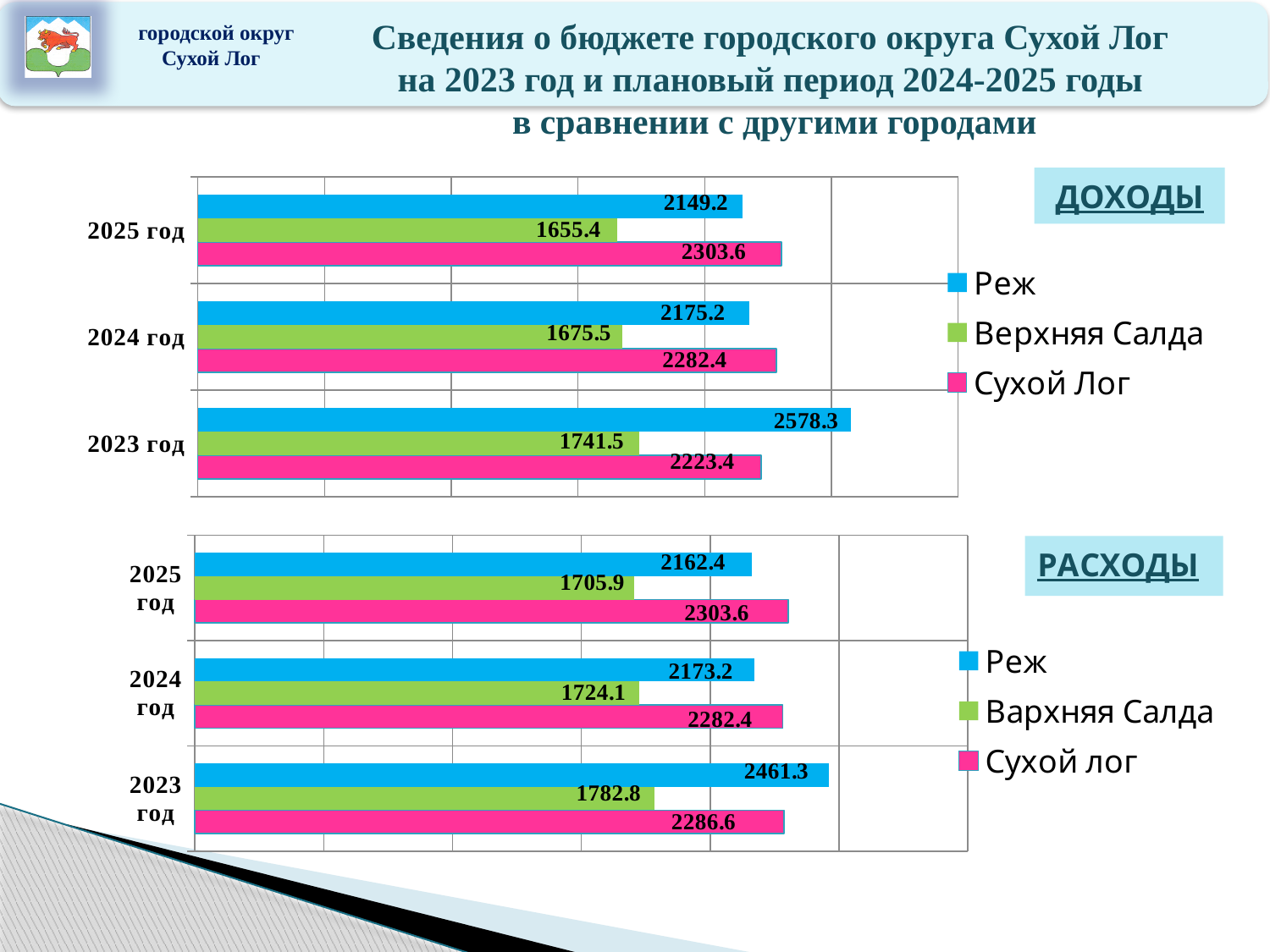
In the РАСХОДЫ chart, which is larger in 2025 год: Реж or Сухой лог? Сухой лог In the РАСХОДЫ chart, how many year categories are shown? 3 What kind of chart is the РАСХОДЫ chart? Bar chart In the РАСХОДЫ chart, what is the difference between Сухой лог and Вархняя Салда in 2023 год? 503.8 In the ДОХОДЫ chart, which city has the lowest value in 2024 год? Верхняя Салда In the РАСХОДЫ chart, what is the value for Реж in 2023 год? 2461.3 In the РАСХОДЫ chart, what is the value for Вархняя Салда in 2024 год? 1724.1 In the ДОХОДЫ chart, what is the value for Верхняя Салда in 2023 год? 1741.5 In the ДОХОДЫ chart, what is the difference between Сухой Лог and Реж in 2025 год? 154.4 In the ДОХОДЫ chart, how many series does the legend list? 3 In the ДОХОДЫ chart, which city has the highest value in 2023 год? Реж In the ДОХОДЫ chart, what is the value for Сухой Лог in 2025 год? 2303.6